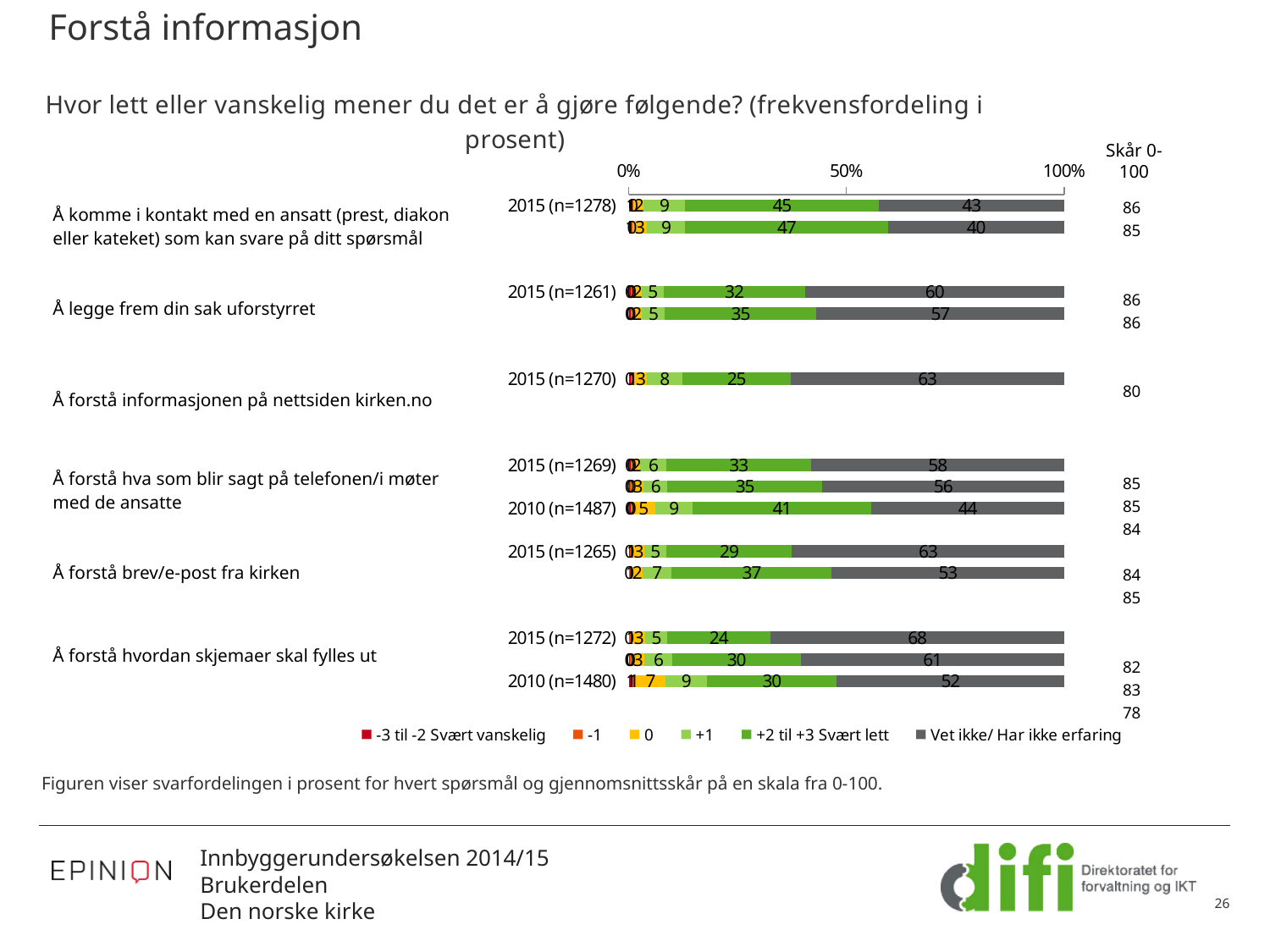
What is the lowest 'Skår 0-100' value shown on the slide? 78 What is the value of the 'Vet ikke/ Har ikke erfaring' segment for the 2015 (n=1270) bar under 'Å forstå informasjonen på nettsiden kirken.no'? 63 What is the 'Skår 0-100' value shown for 'Å forstå informasjonen på nettsiden kirken.no'? 80 Which legend entry is shown in dark grey? Vet ikke/ Har ikke erfaring Which is larger: the '+2 til +3 Svært lett' segment for 2015 (n=1261) or for 2015 (n=1270)? 2015 (n=1261) What kind of chart is shown on the slide? Stacked bar chart What is the value of the '+2 til +3 Svært lett' segment for the 2010 (n=1487) bar under 'Å forstå hva som blir sagt på telefonen/i møter med de ansatte'? 41 What is the difference between the '+2 til +3 Svært lett' segment (45) and the 'Vet ikke/ Har ikke erfaring' segment (43) for the 2015 (n=1278) bar? 2 Which of the 2015 bars has the largest 'Vet ikke/ Har ikke erfaring' segment? 2015 (n=1272), Å forstå hvordan skjemaer skal fylles ut What is the value of the 'Vet ikke/ Har ikke erfaring' segment for the 2015 (n=1272) bar under 'Å forstå hvordan skjemaer skal fylles ut'? 68 How many series does the legend list? 6 What is the value of the '+2 til +3 Svært lett' segment for the 2015 (n=1278) bar under 'Å komme i kontakt med en ansatt'? 45